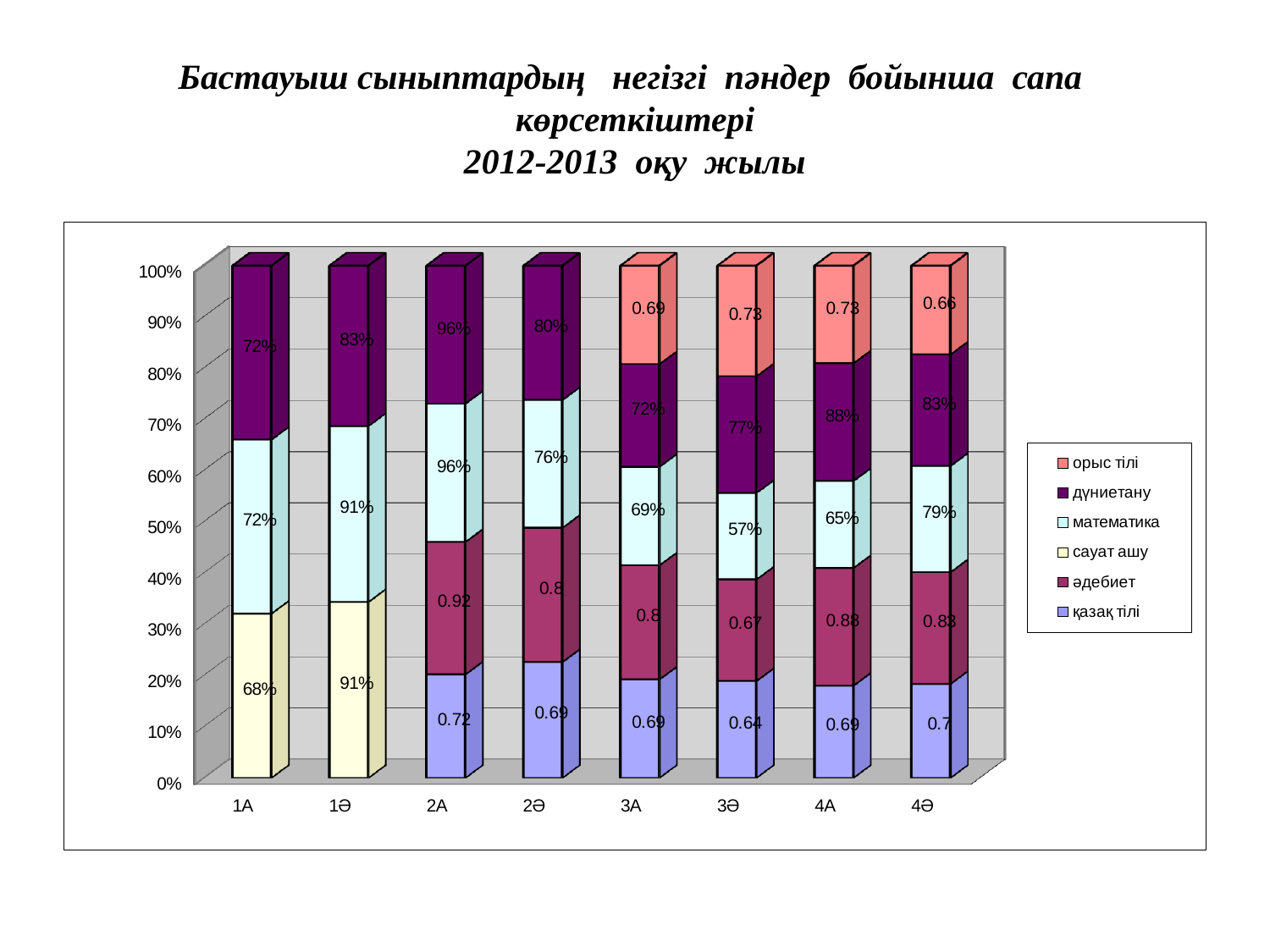
What is the difference between the математика values for 1Ә and 1А? 19% What is the әдебиет value for class 2А? 0.92 What is the математика value for class 1Ә? 91% How many classes (categories) are shown along the x axis? 8 Which class has the lowest математика value? 3Ә What kind of chart is shown on the slide? bar chart What is the сауат ашу value for class 1А? 68% What is the орыс тілі value for class 4Ә? 0.66 Which class has the highest математика value? 2А How many series does the legend list? 6 What is the қазақ тілі value for class 3Ә? 0.64 Which is larger, the дүниетану value for 4А or for 3А? 4А